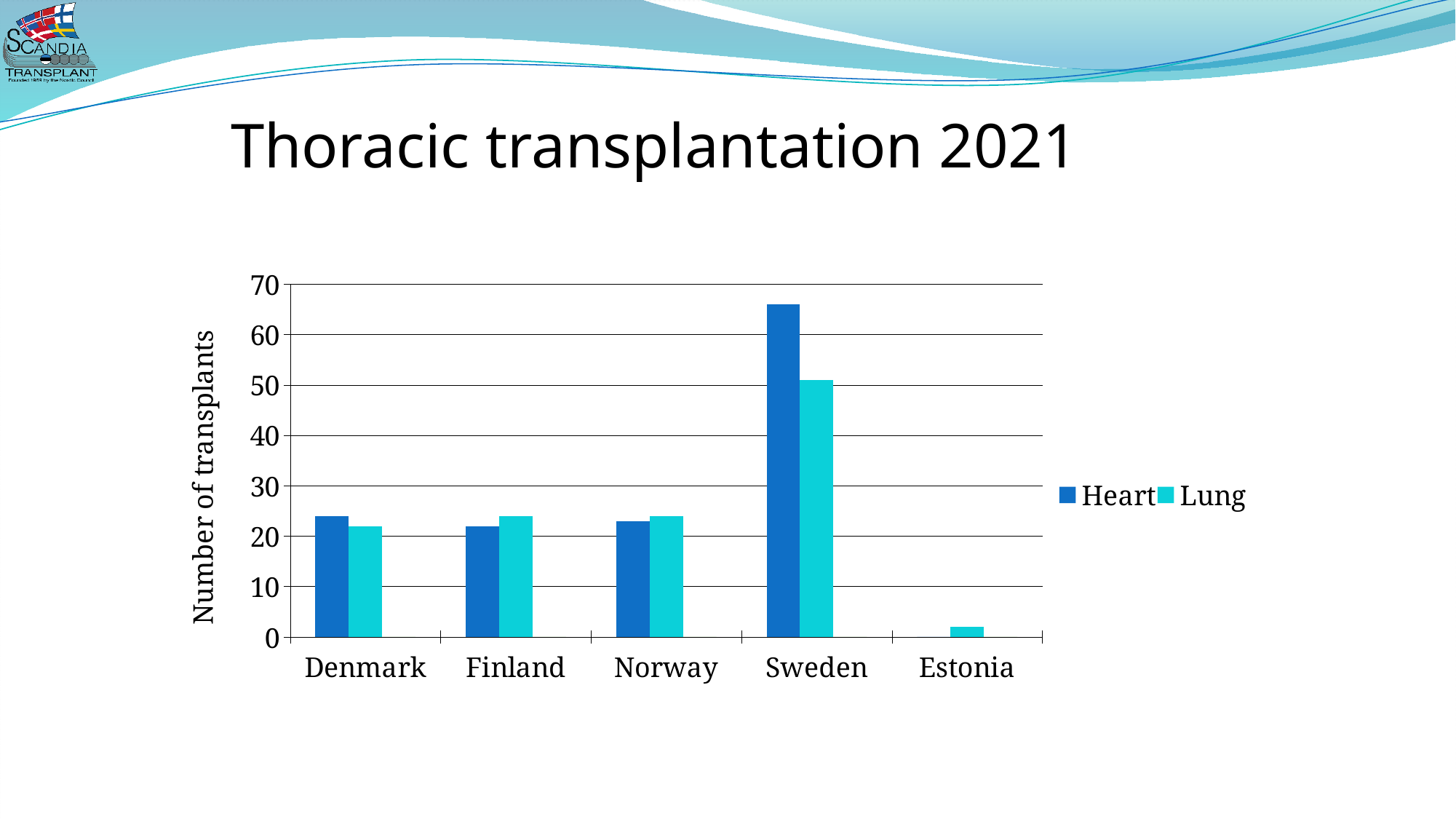
What kind of chart is shown on the slide? bar chart Is the Heart value for Sweden greater or less than 60? greater Which country has the highest Heart value? Sweden How many series does the chart's legend list? 2 Is the Lung value for Sweden greater or less than 60? less What is the title of the y axis of the chart? Number of transplants Which country has the lowest Lung value? Estonia Which is larger, the Heart value for Sweden or the Heart value for Denmark? Sweden Which is larger for Sweden, the Heart value or the Lung value? Heart How many countries are shown on the x axis of the chart? 5 Which country has the highest Lung value? Sweden Is the Lung value for Estonia greater or less than 10? less